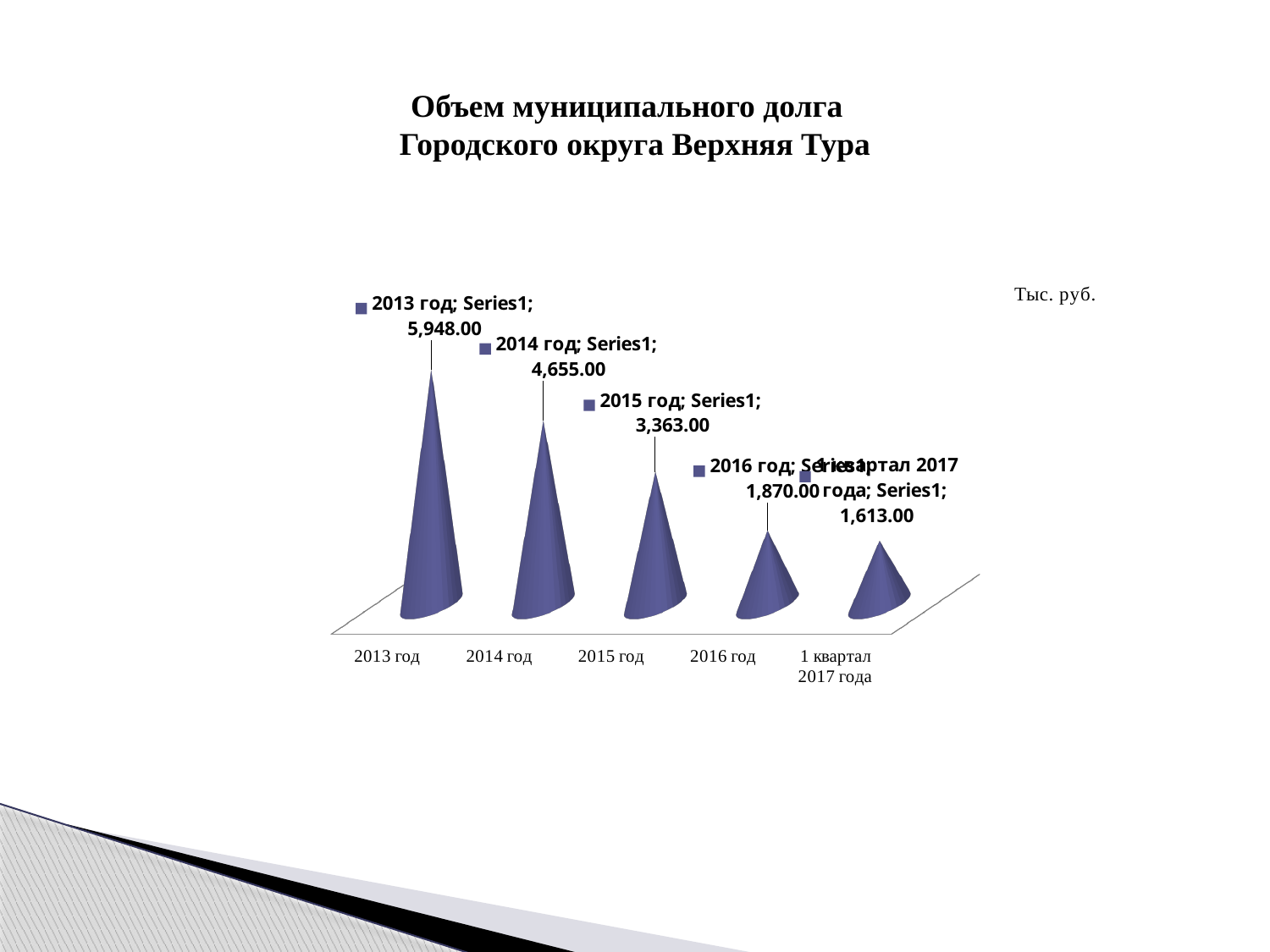
Do the values rise or fall from 2013 год to 1 квартал 2017 года? fall What is the value for 1 квартал 2017 года? 1,613.00 How many categories are shown on the x axis? 5 Which category has the lowest value? 1 квартал 2017 года Which is larger, the value for 2014 год or the value for 2015 год? 2014 год What is the value for 2013 год? 5,948.00 What is the value for 2016 год? 1,870.00 What is the difference between the values for 2013 год and 2014 год? 1,293.00 What is the value for 2015 год? 3,363.00 What is the difference between the values for 2016 год and 1 квартал 2017 года? 257.00 What unit is indicated for the chart values? Тыс. руб. Which category has the highest value? 2013 год